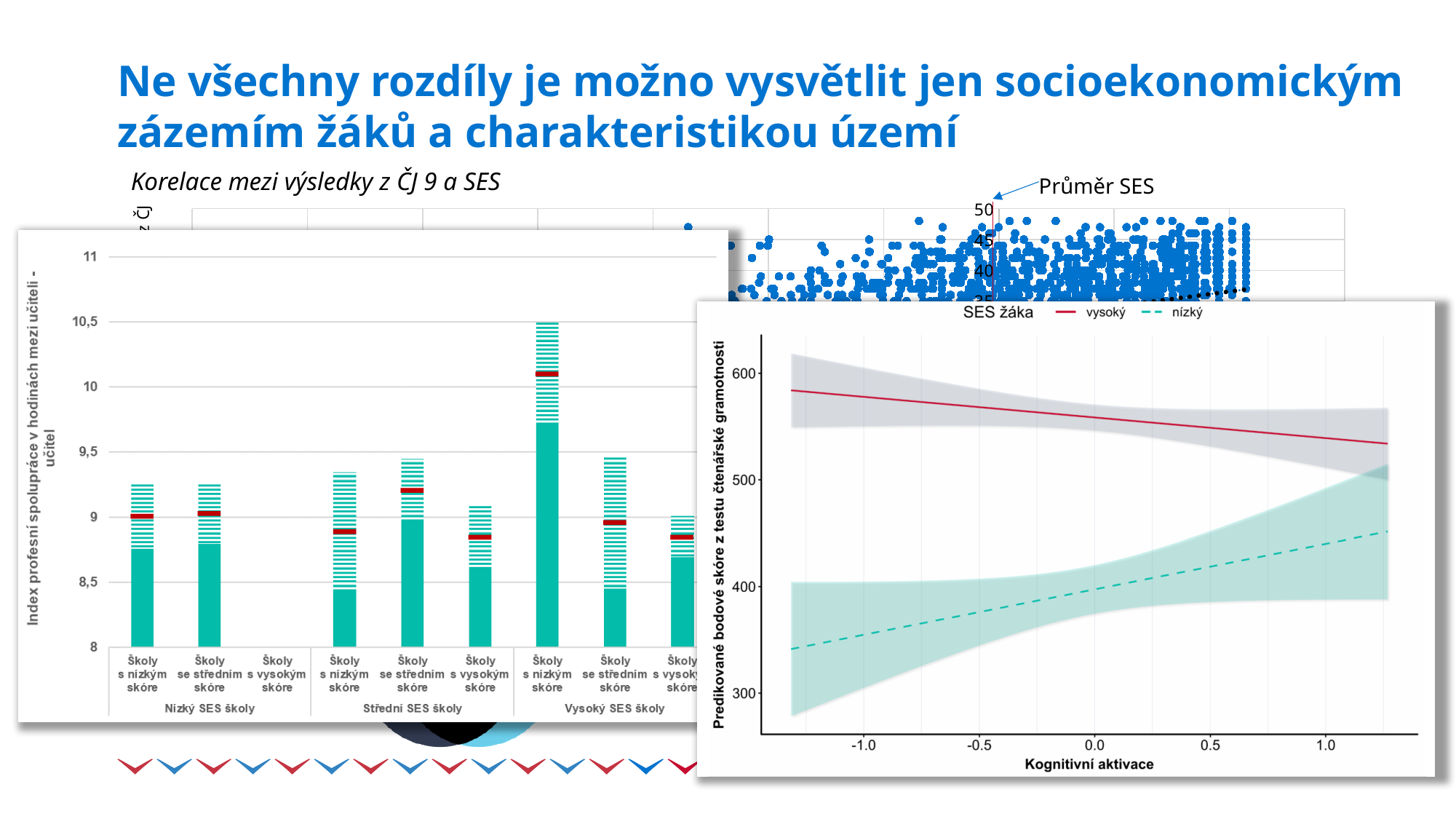
In the bottom-right chart, does the nízký line rise or fall as Kognitivní aktivace increases? rise In the bottom-right chart, how many series does the legend list? 2 In the bottom-left bar chart, is the solid bar for Školy s nízkým skóre in the Vysoký SES školy group greater or less than 9,5? greater In the bottom-right chart, does the vysoký line rise or fall as Kognitivní aktivace increases? fall In the bottom-left bar chart, which category in the Nízký SES školy group has no bar? Školy s vysokým skóre In the bottom-left bar chart, how many school SES groups are shown along the x axis? 3 In the bottom-right chart, is the vysoký line at Kognitivní aktivace -1.0 greater or less than 500? greater In the bottom-right chart, at Kognitivní aktivace 0.0, which series has the higher predicted score, vysoký or nízký? vysoký What is the title of the scatter chart at the top of the slide? Korelace mezi výsledky z ČJ 9 a SES In the bottom-left bar chart, is the solid bar for Školy s nízkým skóre in the Nízký SES školy group greater or less than 9? less What kind of chart is the bottom-left chart? bar chart In the bottom-left bar chart, which category has the highest bar? Školy s nízkým skóre (Vysoký SES školy)